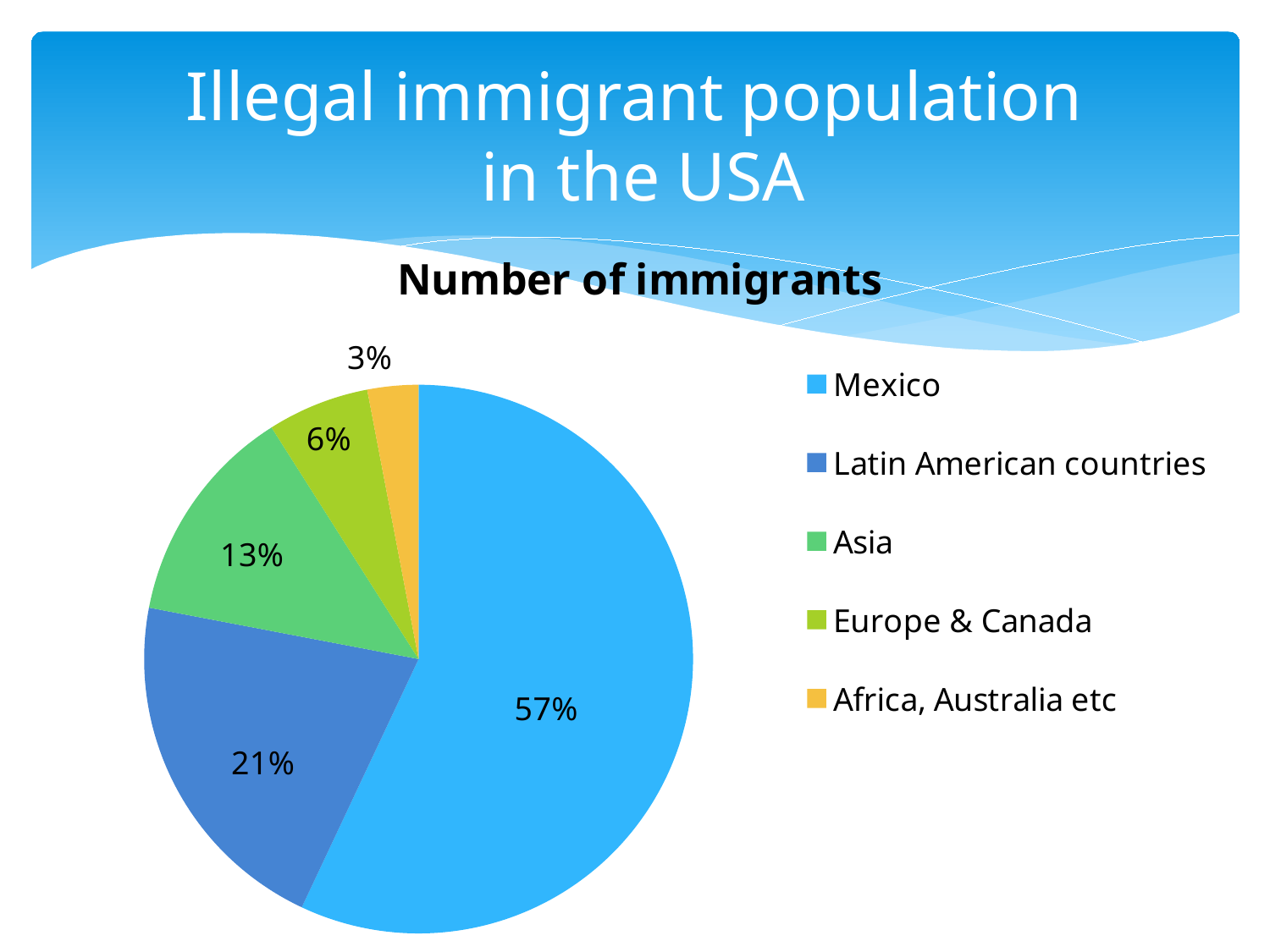
What share of the pie does Europe & Canada account for? 6% What share of the pie does Asia account for? 13% What type of chart is shown on the slide? pie chart What share of the pie does Africa, Australia etc account for? 3% Which category has the largest slice of the pie? Mexico Which category has the smallest slice of the pie? Africa, Australia etc What is the title of the chart? Number of immigrants How many categories does the pie chart show? 5 Which is larger, the share for Asia or the share for Europe & Canada? Asia What is the difference in percentage points between Mexico and Latin American countries? 36